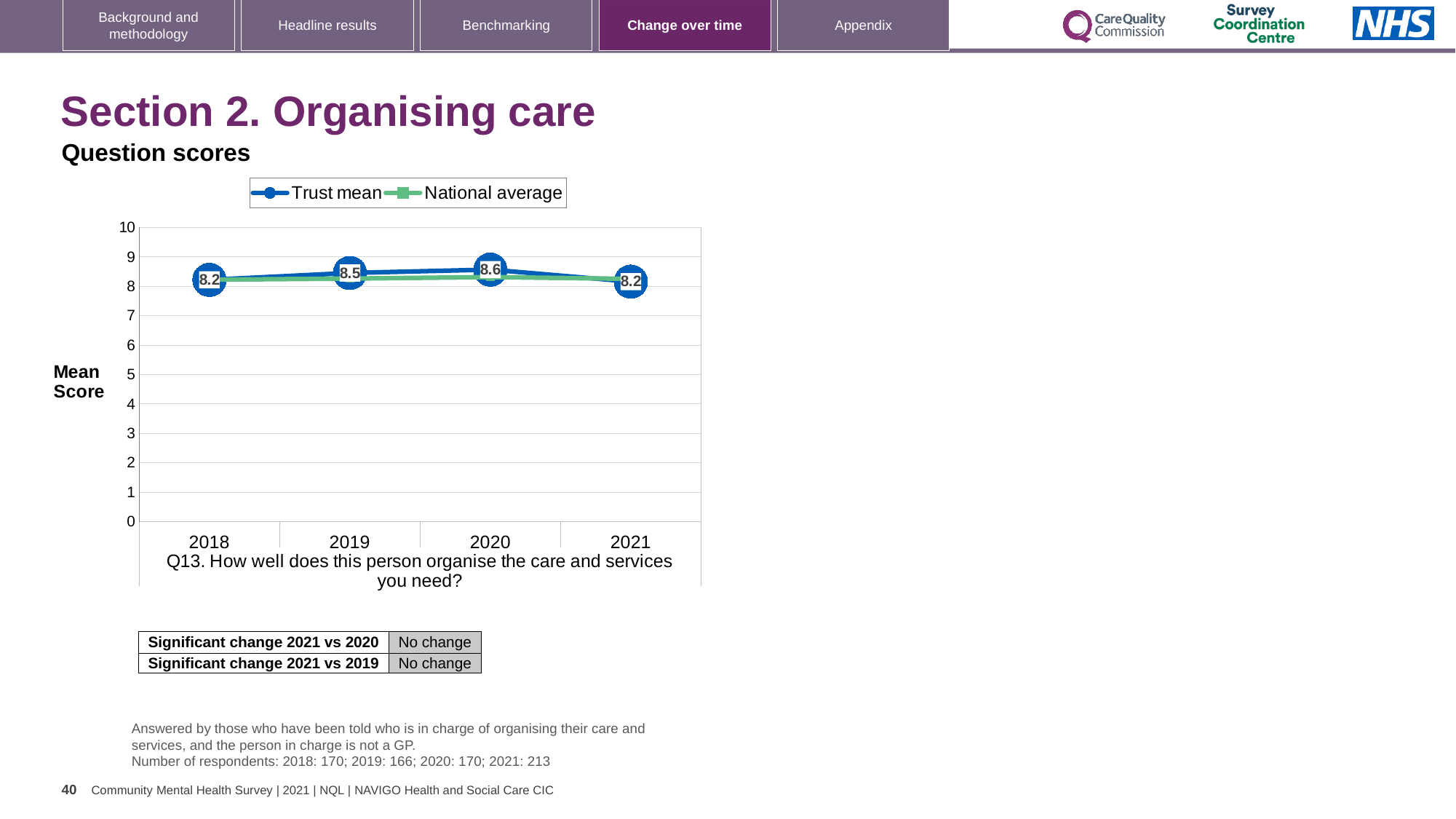
How many years are plotted on the x axis? 4 What is the difference between the Trust mean score in 2020 and in 2018? 0.4 What is the Trust mean score for 2021? 8.2 Which is larger, the Trust mean score for 2019 or for 2021? 2019 What kind of chart is shown on the slide? Line chart In which year is the Trust mean score highest? 2020 How many series does the legend list? 2 Does the Trust mean score rise or fall from 2020 to 2021? Fall Is the National average value for 2018 greater or less than 9? less What is the Trust mean score for 2019? 8.5 What is the Trust mean score for 2020? 8.6 Is the National average value for 2020 greater or less than 5? greater